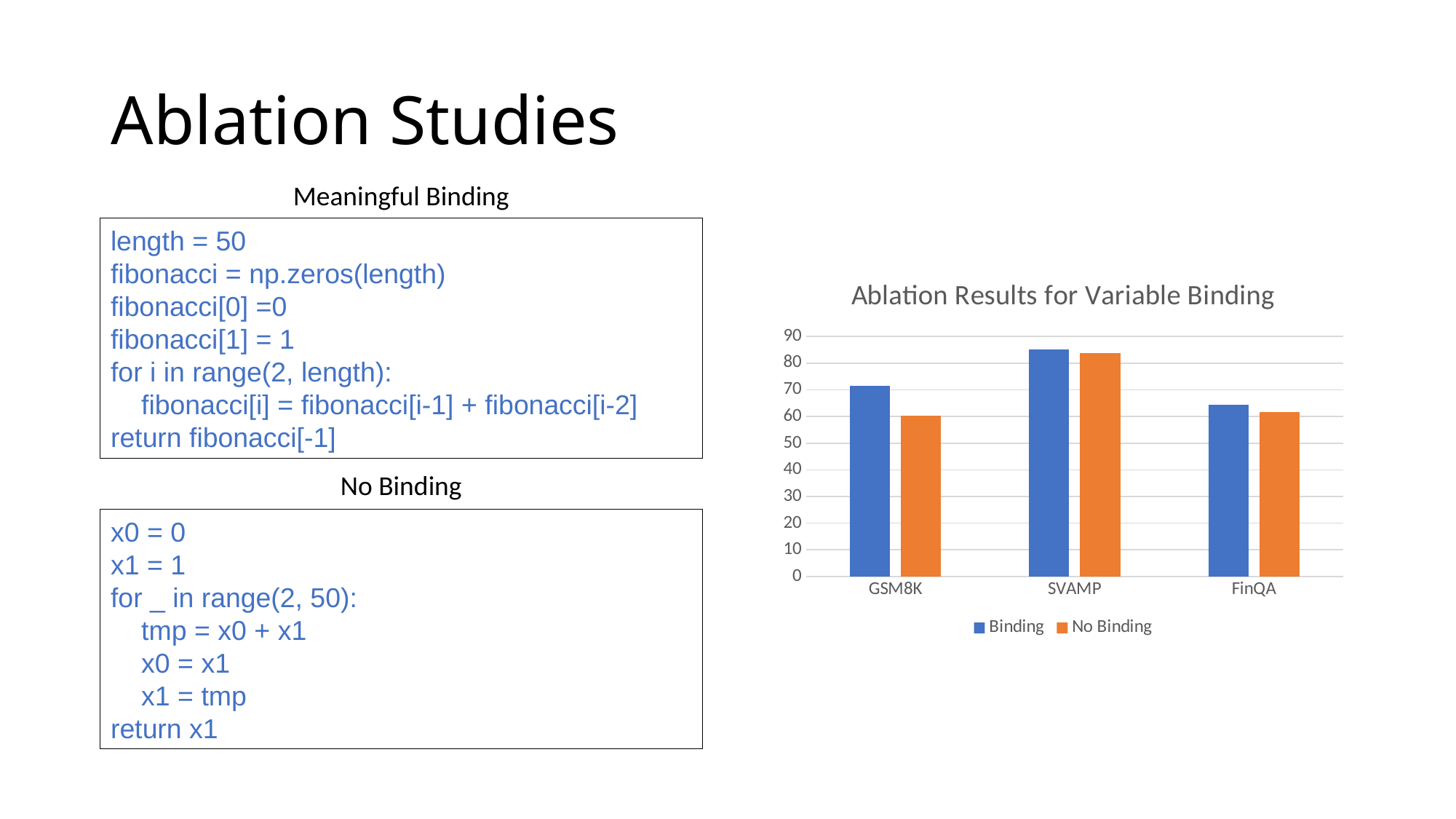
For GSM8K, which is larger: the Binding value or the No Binding value? Binding What kind of chart is shown on the slide? bar chart What is the title of the chart? Ablation Results for Variable Binding For which category is the No Binding value highest? SVAMP Is the Binding value for FinQA greater or less than 50? greater Is the Binding value for SVAMP greater or less than 80? greater Which series is shown in orange in the chart? No Binding For which category is the Binding value lowest? FinQA How many series does the chart's legend list? 2 Is the No Binding value for GSM8K greater or less than 70? less For which category is the Binding value highest? SVAMP How many categories are shown on the x axis of the chart? 3